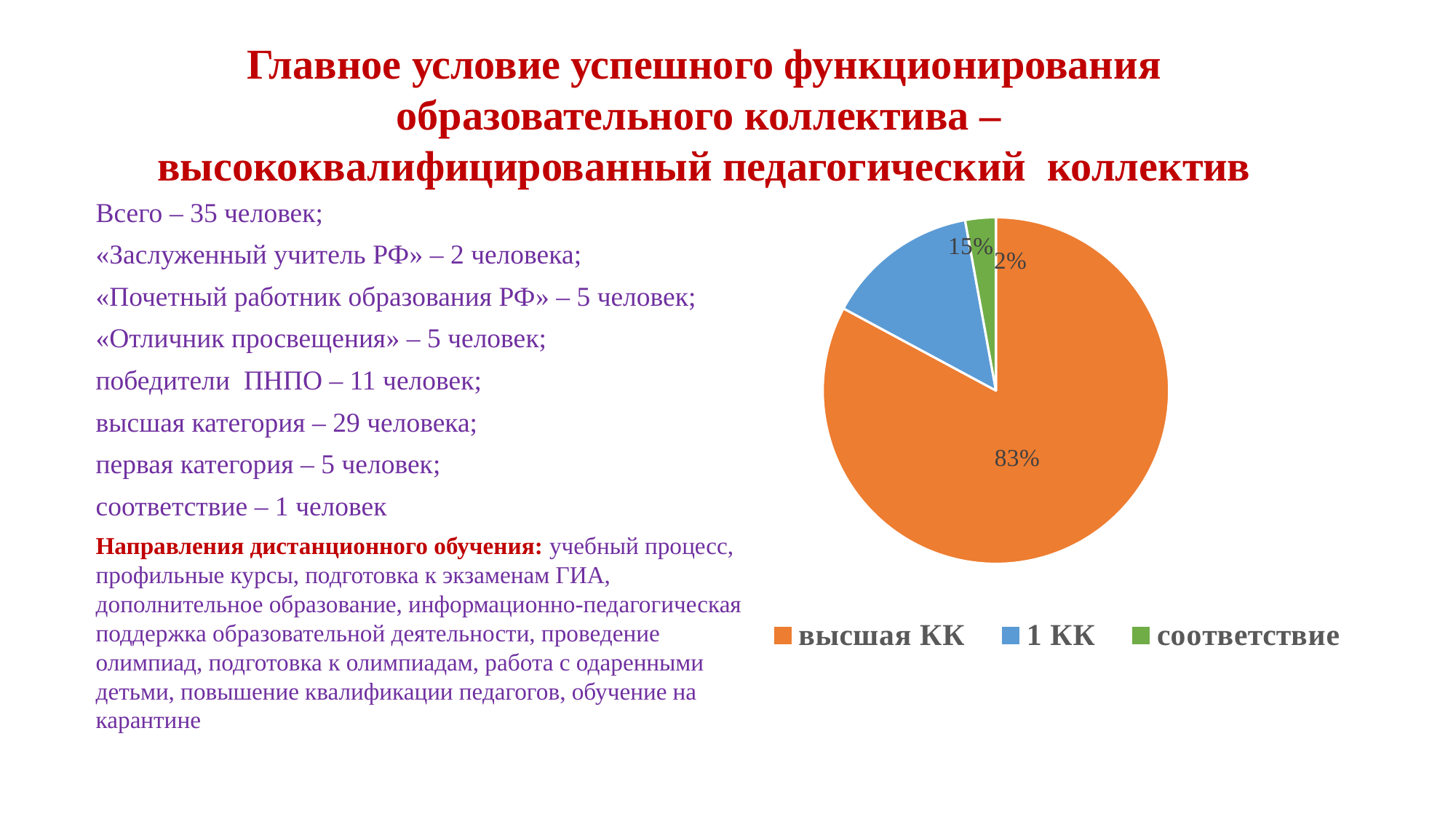
What is the difference in percentage points between "высшая КК" and "1 КК"? 68 What colour is the slice for "соответствие"? green What colour is the slice for "1 КК"? blue What share of the pie does "1 КК" have? 15% How many slices does the pie chart have? 3 Which category has the smallest slice of the pie? соответствие Which is larger, the slice for "1 КК" or the slice for "соответствие"? 1 КК What share of the pie does "соответствие" have? 2% What share of the pie does "высшая КК" have? 83% How many entries does the legend list? 3 What kind of chart is shown on the slide? pie chart Which category has the largest slice of the pie? высшая КК